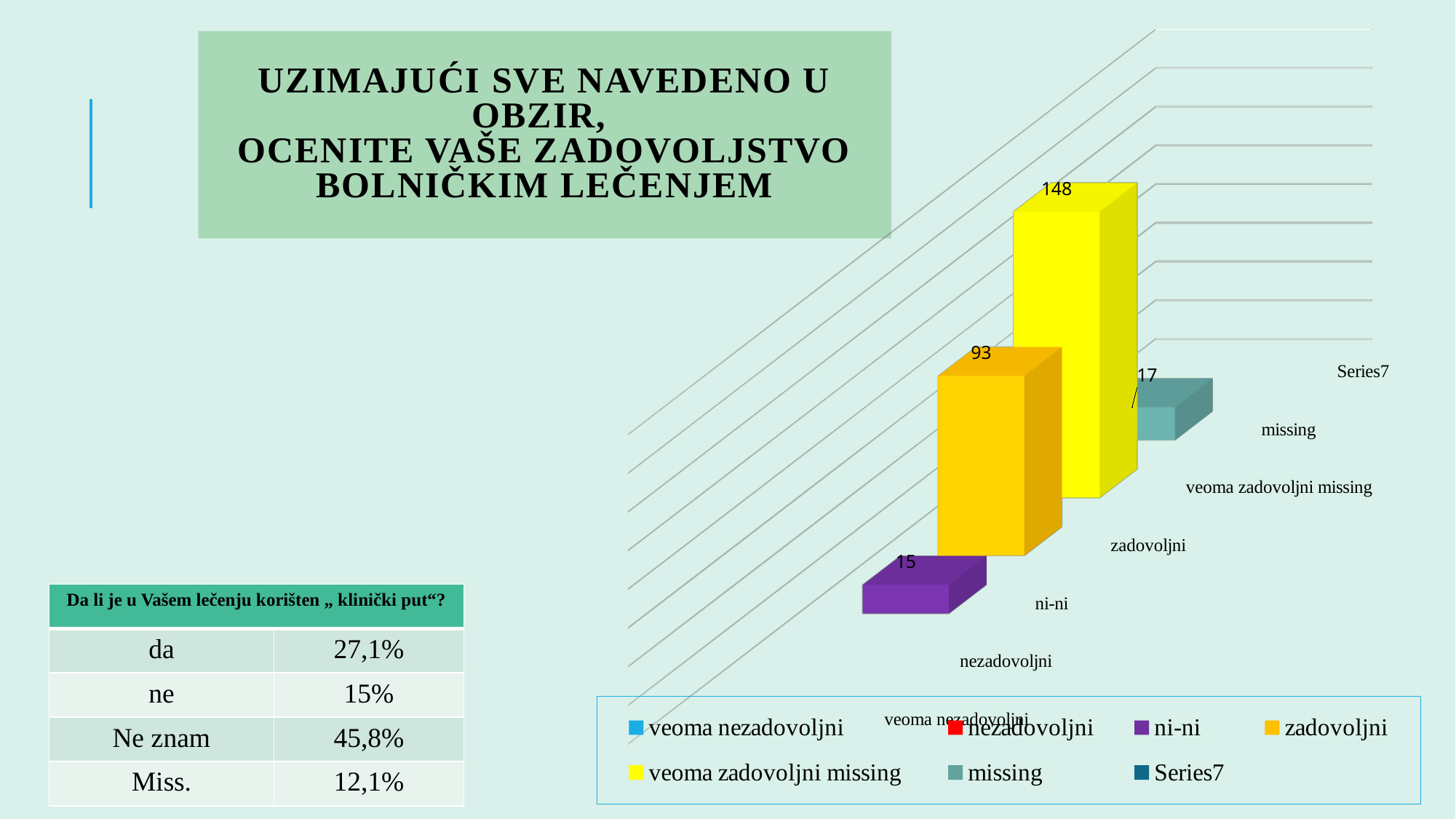
What is the value for veoma zadovoljni missing? 148 What is the difference between the values for missing and ni-ni? 2 How many entries does the legend list? 7 What is the value for zadovoljni? 93 What is the difference between the values for veoma zadovoljni missing and zadovoljni? 55 Which is larger, the value for missing or the value for ni-ni? missing What kind of chart is shown? bar chart Which is larger, the value for zadovoljni or the value for ni-ni? zadovoljni What colour is the bar for zadovoljni? orange What is the value for ni-ni? 15 Which category has the highest value? veoma zadovoljni missing What is the value for missing? 17